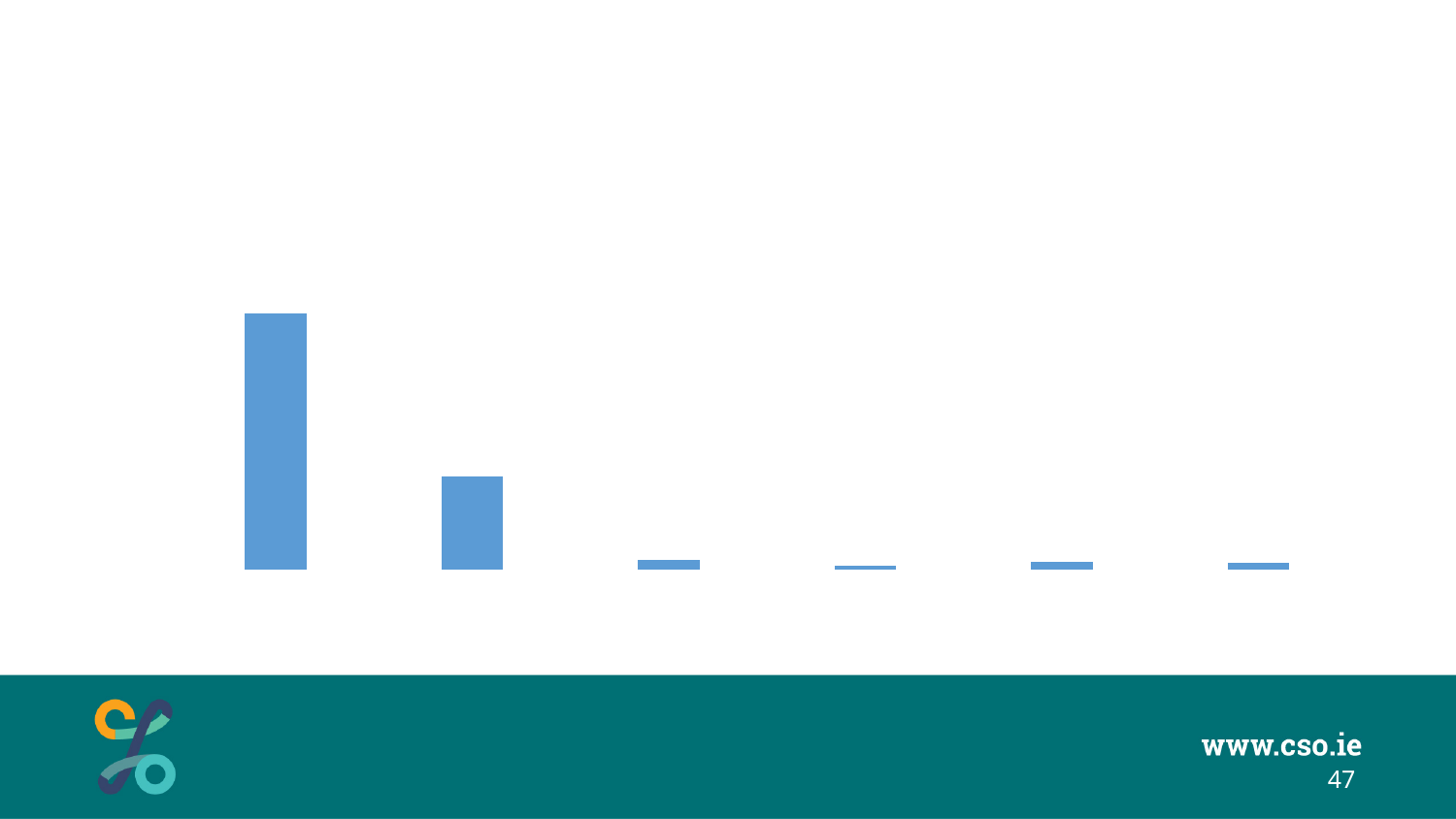
Do the bar heights generally rise or fall from left to right across the chart? fall What kind of chart is shown on the slide? bar chart Which is taller, the first bar from the left or the second bar from the left? the first bar from the left Which bar in the chart is the tallest, by position from the left? the first bar How many bars are plotted in the chart? 6 What colour are the bars in the chart? blue